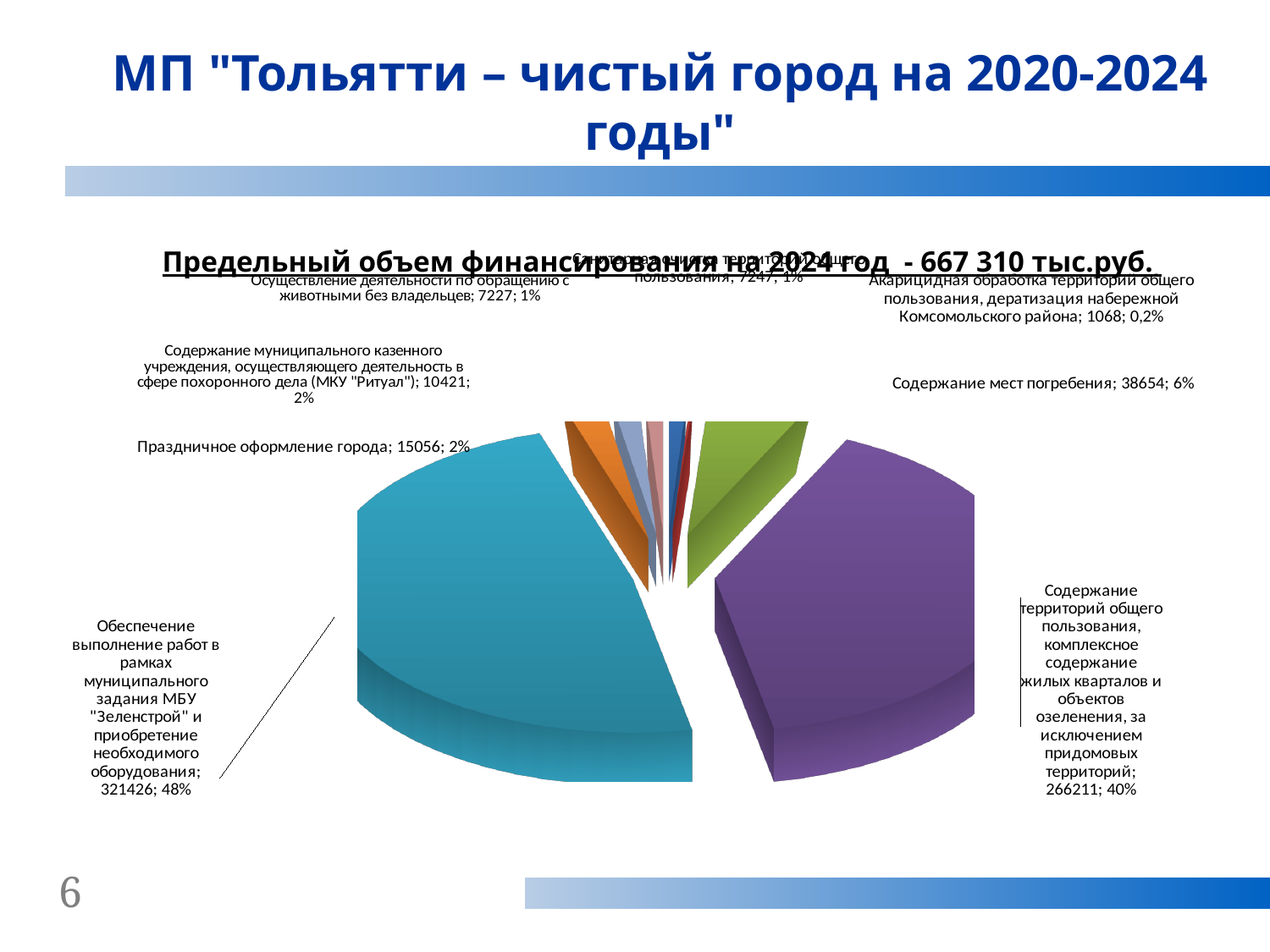
What is the difference between the value for МБУ "Зеленстрой" (321426) and the value for "Содержание территорий общего пользования" (266211)? 55215 What share of the pie does "Обеспечение выполнение работ в рамках муниципального задания МБУ "Зеленстрой"" represent? 48% What share of the pie does "Содержание территорий общего пользования, комплексное содержание жилых кварталов и объектов озеленения" represent? 40% What kind of chart is shown on the slide? pie chart How many slices does the pie chart have? 8 What is the value for "Праздничное оформление города"? 15056 According to the chart title, what is the total funding limit for 2024? 667 310 тыс.руб. What is the value for "Обеспечение выполнение работ в рамках муниципального задания МБУ "Зеленстрой" и приобретение необходимого оборудования"? 321426 Which is larger: the value for "Праздничное оформление города" or the value for "Содержание муниципального казенного учреждения (МКУ "Ритуал")"? Праздничное оформление города Which category has the smallest slice of the pie? Акарицидная обработка территорий общего пользования, дератизация набережной Комсомольского района What is the value for "Содержание мест погребения"? 38654 Which category has the largest slice of the pie? Обеспечение выполнение работ в рамках муниципального задания МБУ "Зеленстрой" и приобретение необходимого оборудования